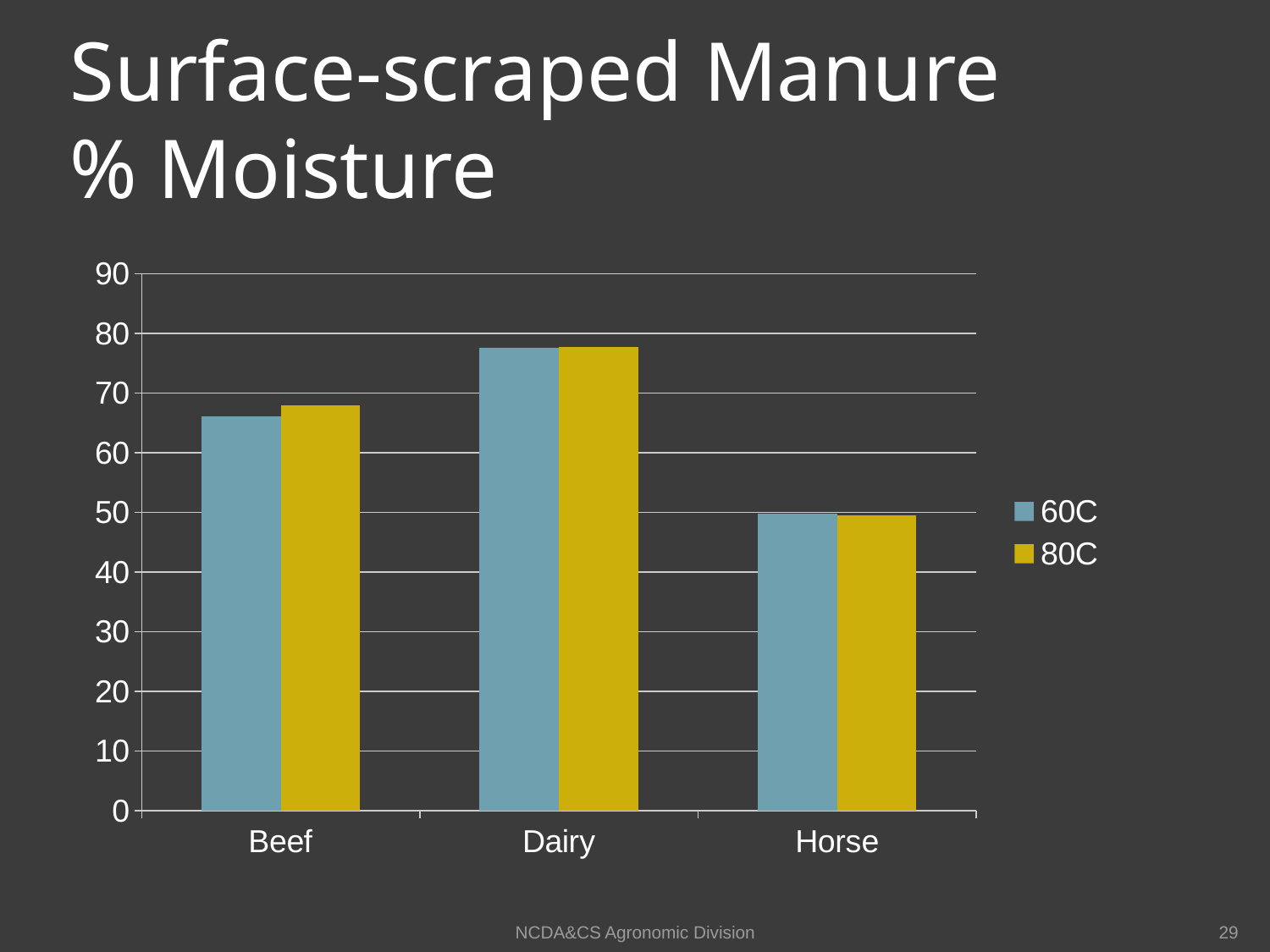
Which is larger in the 60C series, the value for Beef or the value for Dairy? Dairy Which category has the highest value for the 60C series? Dairy How many categories are shown on the x axis? 3 Which category has the highest value for the 80C series? Dairy Is the value for Beef in the 60C series greater or less than 60? greater Which category has the lowest value for the 80C series? Horse What kind of chart is shown on the slide? bar chart Is the value for Beef in the 80C series greater or less than 70? less How many series does the legend list? 2 Is the value for Dairy in the 80C series greater or less than 80? less What are the two series named in the legend? 60C and 80C